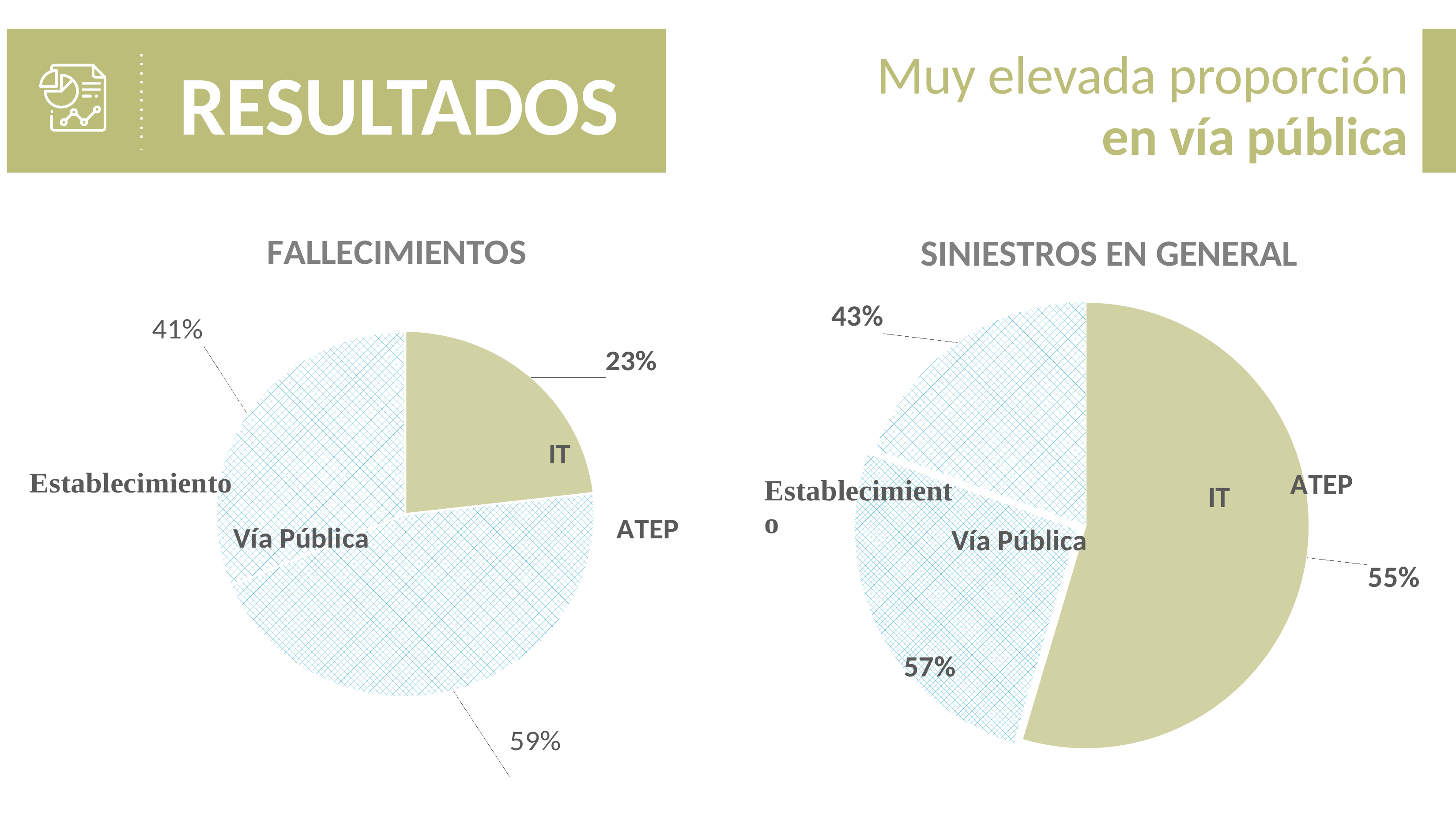
In the FALLECIMIENTOS chart, what is the difference in percentage points between the Vía Pública label and the Establecimiento label? 18 percentage points In the SINIESTROS EN GENERAL chart, what percentage is labelled for Vía Pública? 57% In the FALLECIMIENTOS chart, what percentage is labelled for Establecimiento? 41% What is the title of the chart on the right side of the slide? SINIESTROS EN GENERAL What kind of chart is the FALLECIMIENTOS chart? Pie chart In the SINIESTROS EN GENERAL chart, what is the difference in percentage points between the Vía Pública label and the Establecimiento label? 14 percentage points In the SINIESTROS EN GENERAL chart, what percentage is labelled for Establecimiento? 43% In the FALLECIMIENTOS chart, which has the larger labelled percentage, Establecimiento or Vía Pública? Vía Pública Which chart shows the larger labelled percentage for IT, FALLECIMIENTOS or SINIESTROS EN GENERAL? SINIESTROS EN GENERAL In the SINIESTROS EN GENERAL chart, what percentage is labelled for the IT slice? 55% In the FALLECIMIENTOS chart, what percentage is labelled for the IT slice? 23% In the FALLECIMIENTOS chart, what percentage is labelled for Vía Pública? 59%